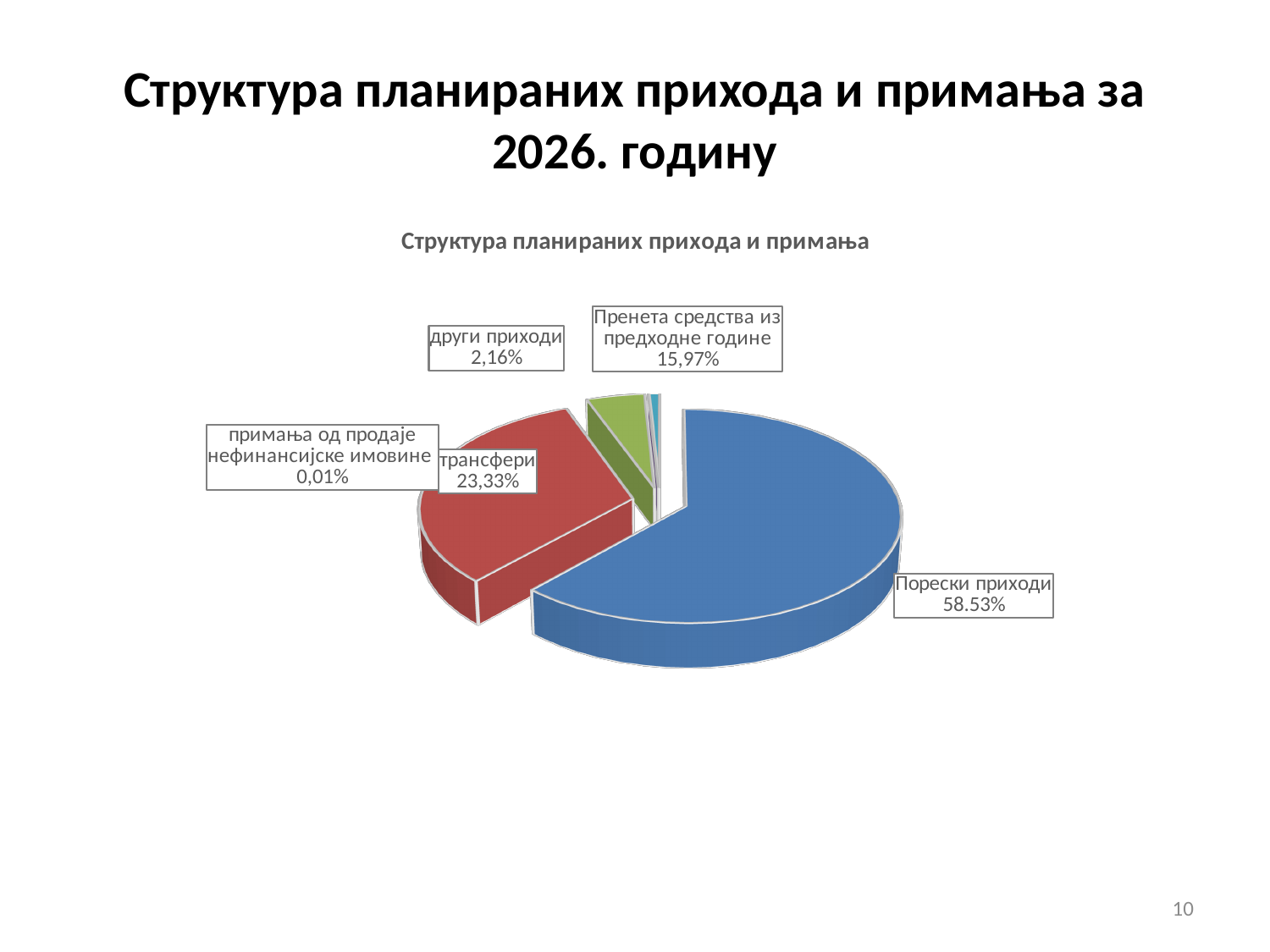
What kind of chart is shown on the slide? pie chart What share of the pie is labelled for Пренета средства из предходне године? 15,97% Which category has the smallest slice of the pie? примања од продаје нефинансијске имовине What share of the pie is labelled for Порески приходи? 58.53% What share of the pie is labelled for други приходи? 2,16% What is the chart's title? Структура планираних прихода и примања Which is larger, the share for трансфери or the share for Пренета средства из предходне године? трансфери What share of the pie is labelled for трансфери? 23,33% What colour is the slice for Порески приходи? blue How many slices does the pie chart have? 5 Which category has the largest slice of the pie? Порески приходи What share of the pie is labelled for примања од продаје нефинансијске имовине? 0,01%